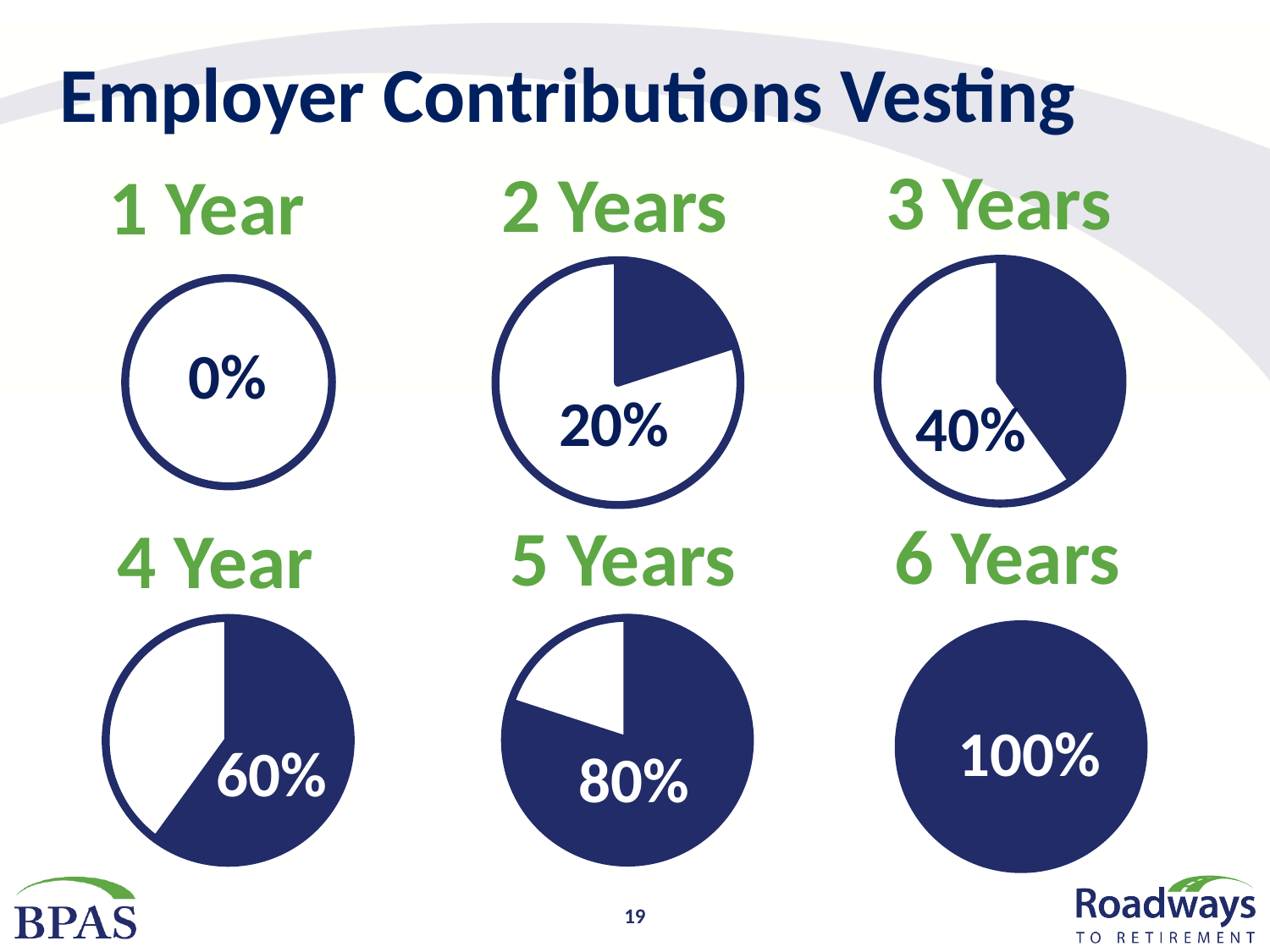
Do the vesting percentages rise or fall as the number of years increases? rise Which year label has the lowest vesting percentage? 1 Year How many pie charts are shown on the slide? 6 What is the difference between the vesting percentage at 5 Years and at 2 Years? 60% What vesting percentage is shown for 5 Years? 80% Which year label has the highest vesting percentage? 6 Years Which is larger, the vesting percentage at 3 Years or at 4 Year? 4 Year What vesting percentage is shown for 1 Year? 0% What vesting percentage is shown for 2 Years? 20% What vesting percentage is shown for 6 Years? 100% What vesting percentage is shown for 3 Years? 40% What vesting percentage is shown for 4 Year? 60%